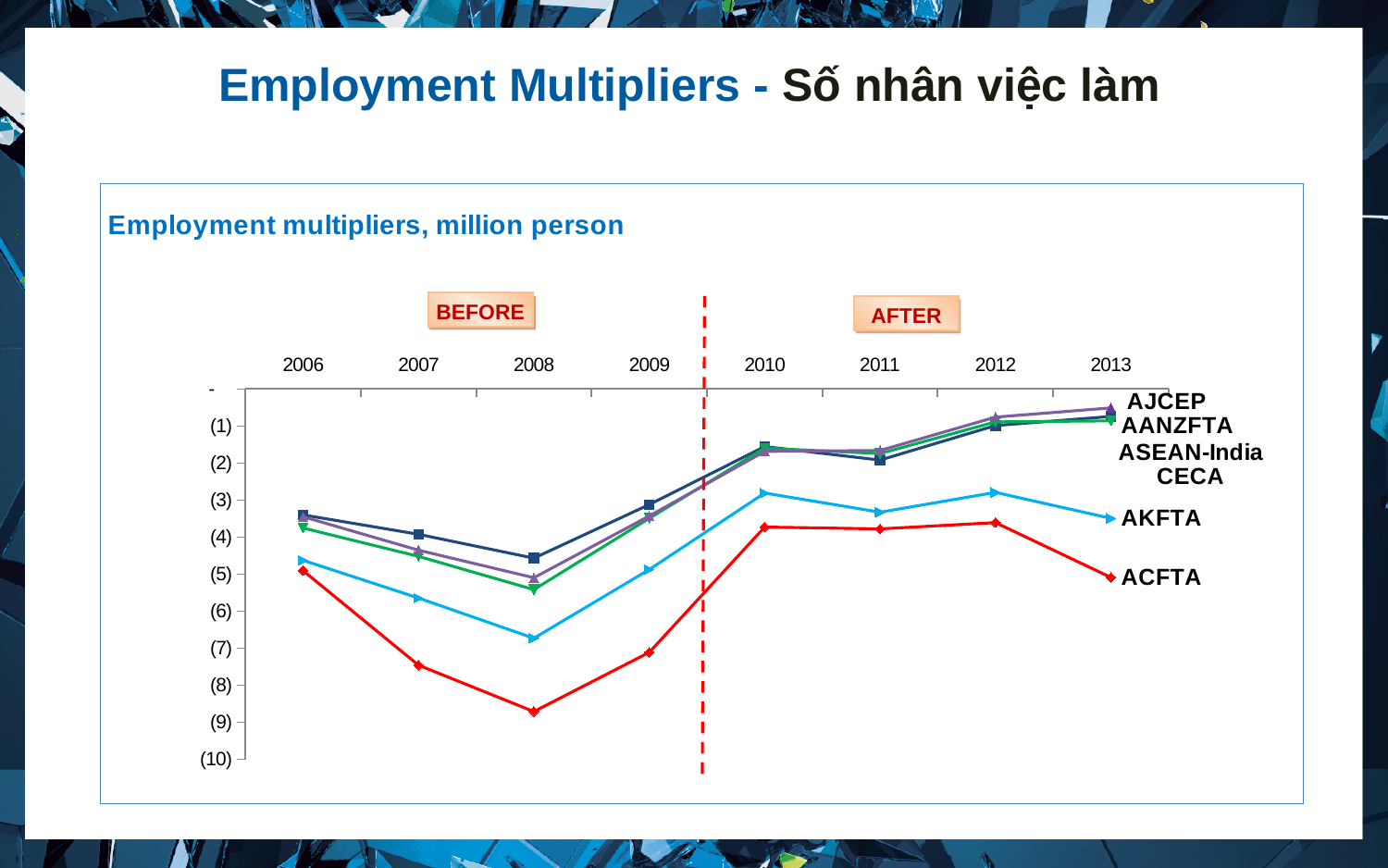
How many series does the chart plot? 5 Does the AKFTA series rise or fall from 2008 to 2010? rise In which year does the ACFTA series reach its lowest value? 2008 How many years are shown along the x axis? 8 Which series has the lowest value in 2008? ACFTA Is the value for AKFTA in 2012 greater or less than (3)? greater Does the ACFTA series rise or fall from 2006 to 2008? fall Is the value for ACFTA in 2008 greater or less than (8)? less Which is larger in 2009, the value for ACFTA or the value for AKFTA? AKFTA What is the title printed above the chart? Employment multipliers, million person Which series has the lowest value in 2013? ACFTA What kind of chart is shown on the slide? line chart